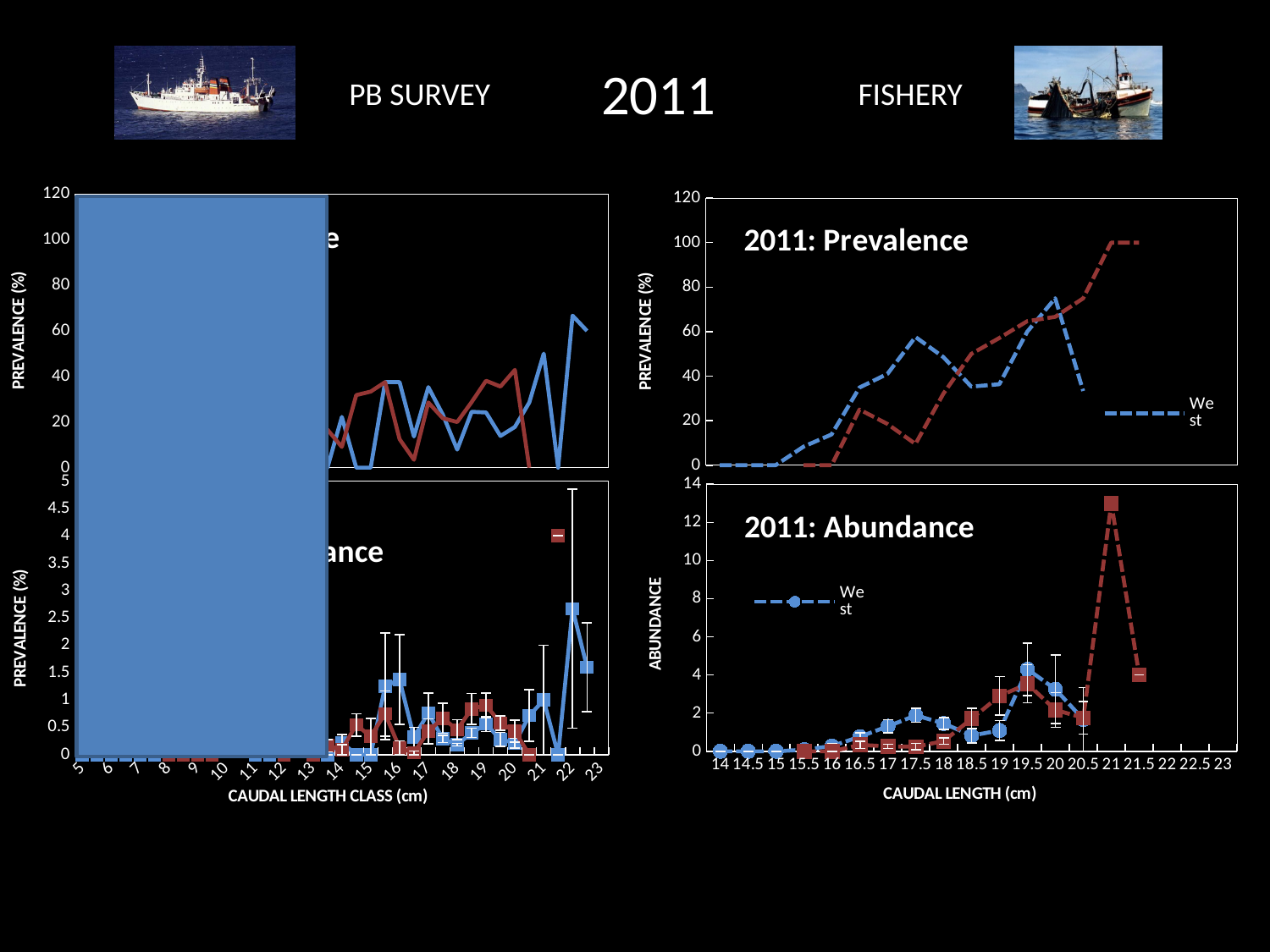
In the '2011: Prevalence' chart on the right, is the value of the West (blue) series at caudal length 20 greater or less than 60? greater In the '2011: Abundance' chart on the right, at which caudal length does the red series reach its highest value? 21 In the '2011: Prevalence' chart on the right, is the value of the red series at caudal length 21 greater or less than 80? greater In the '2011: Abundance' chart on the right, what is the abundance value for the West series at caudal length 14? 0 In the '2011: Abundance' chart on the right, is the value of the red series at caudal length 21 greater or less than 12? greater In the '2011: Prevalence' chart on the right, does the red series generally rise or fall as caudal length increases? rise In the '2011: Abundance' chart on the right, which is larger: the West (blue) series value at caudal length 19.5 or at caudal length 17.5? 19.5 In the '2011: Abundance' chart on the right, which is larger: the red series value at caudal length 21 or at caudal length 21.5? 21 In the '2011: Abundance' chart on the right, which series is named in the legend? West What kind of chart is the '2011: Prevalence' chart on the right of the slide? line chart In the '2011: Prevalence' chart on the right, what is the prevalence value for the West series at caudal length 14? 0